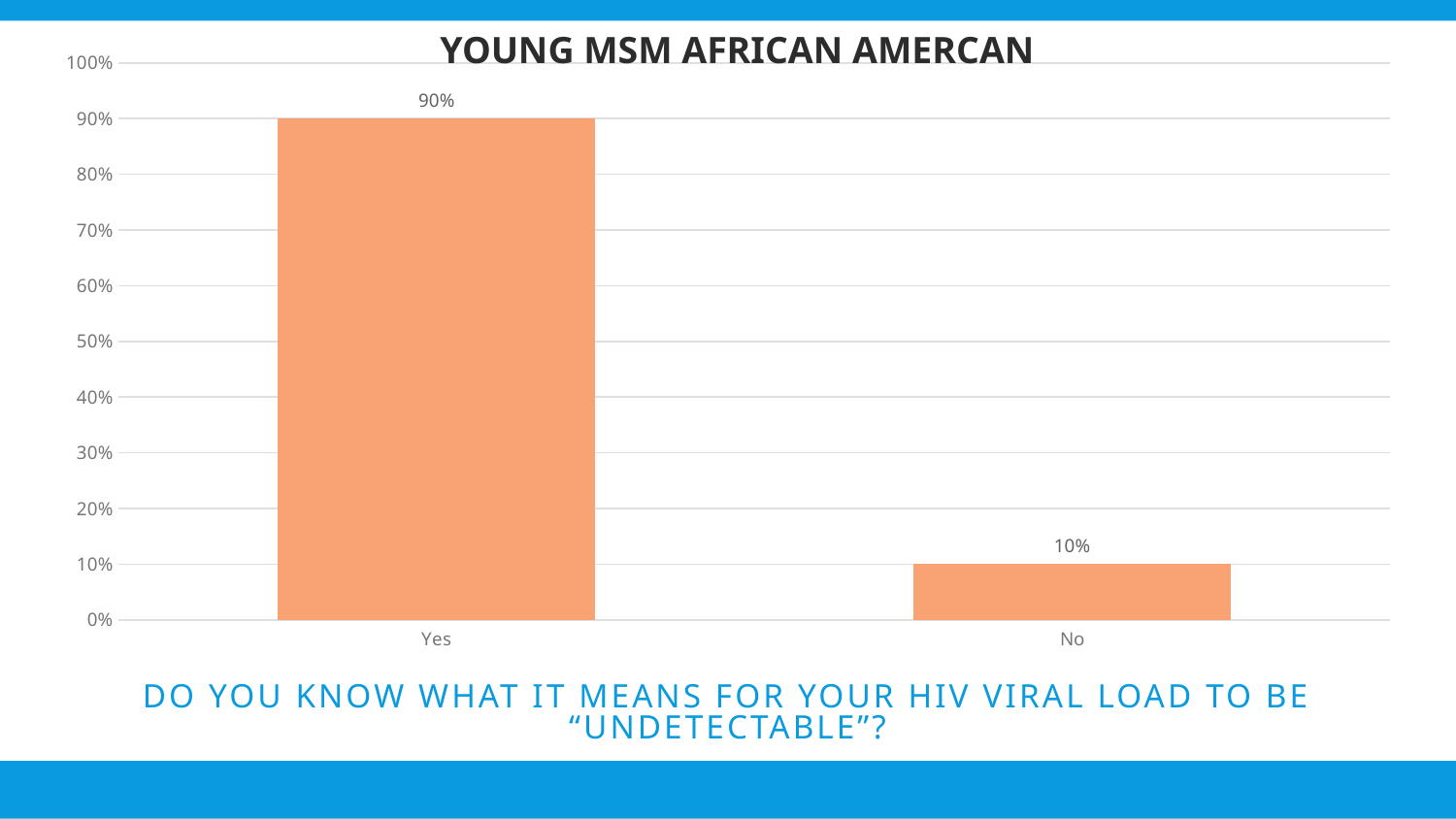
Which category has the lowest value? No What is the highest value shown on the vertical axis? 100% What is the difference between the values for Yes and No? 80% What is the title of the chart? YOUNG MSM AFRICAN AMERCAN What is the value for Yes? 90% Is the value for No greater or less than 20%? less What is the value for No? 10% How many categories are shown on the chart? 2 Which category has the highest value? Yes What kind of chart is shown on the slide? Bar chart Is the value for Yes greater or less than 50%? greater Which is larger, the value for Yes or the value for No? Yes